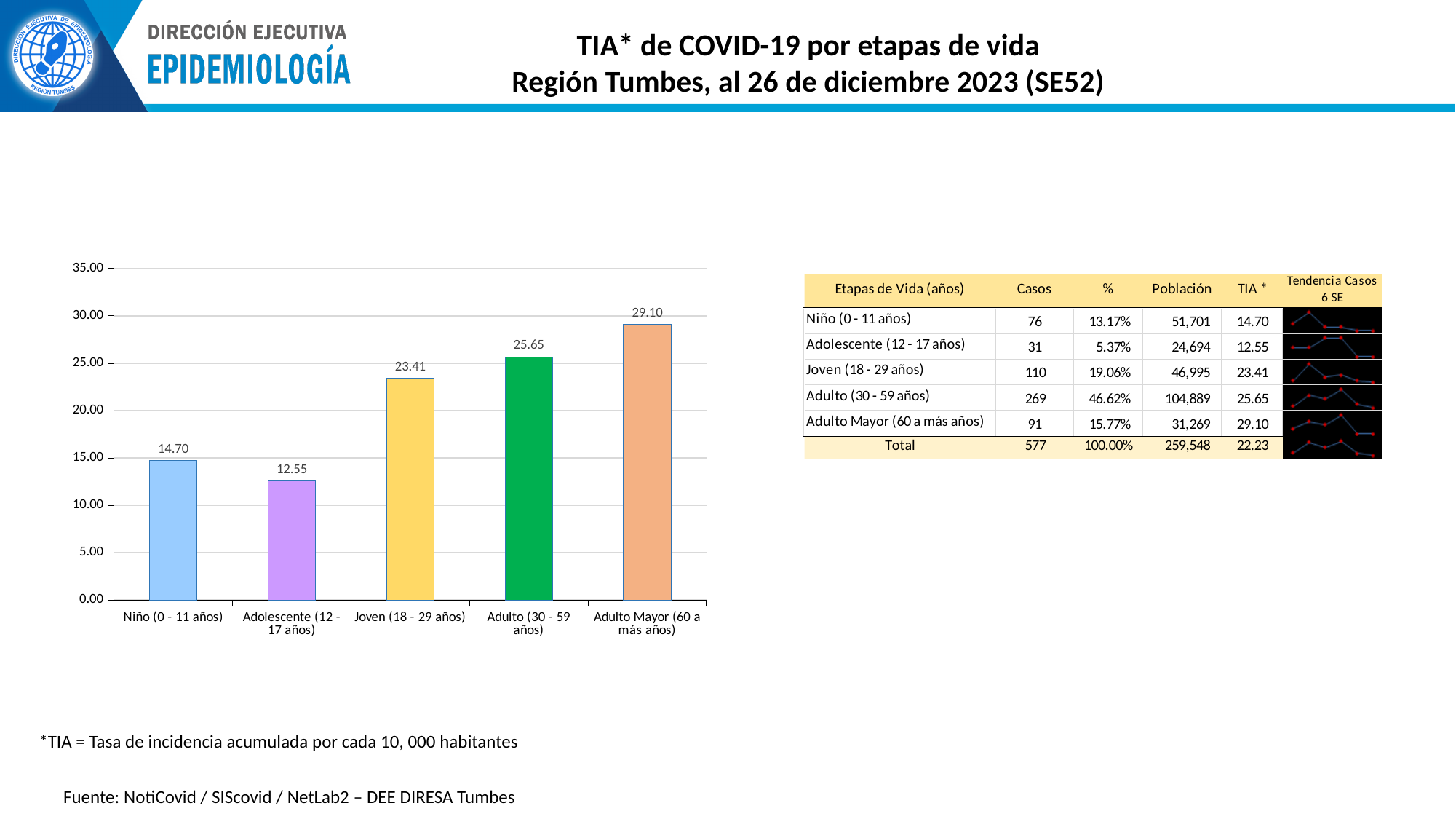
Which age group has the lowest TIA in the bar chart? Adolescente (12 - 17 años) How many age groups are shown in the bar chart? 5 What is the difference between the TIA for Adulto Mayor (60 a más años) and Niño (0 - 11 años)? 14.40 What colour is the bar for Adulto (30 - 59 años)? Green What type of chart is used to show TIA by age group? Bar chart What is the difference between the TIA for Adulto (30 - 59 años) and Joven (18 - 29 años)? 2.24 What is the TIA value shown for Niño (0 - 11 años) in the bar chart? 14.70 Which age group has the highest TIA in the bar chart? Adulto Mayor (60 a más años) Which has a higher TIA in the bar chart, Joven (18 - 29 años) or Adolescente (12 - 17 años)? Joven (18 - 29 años) What is the TIA value shown for Joven (18 - 29 años) in the bar chart? 23.41 Is the TIA value for Adulto Mayor (60 a más años) greater or less than 25.00? greater What is the TIA value shown for Adulto (30 - 59 años) in the bar chart? 25.65